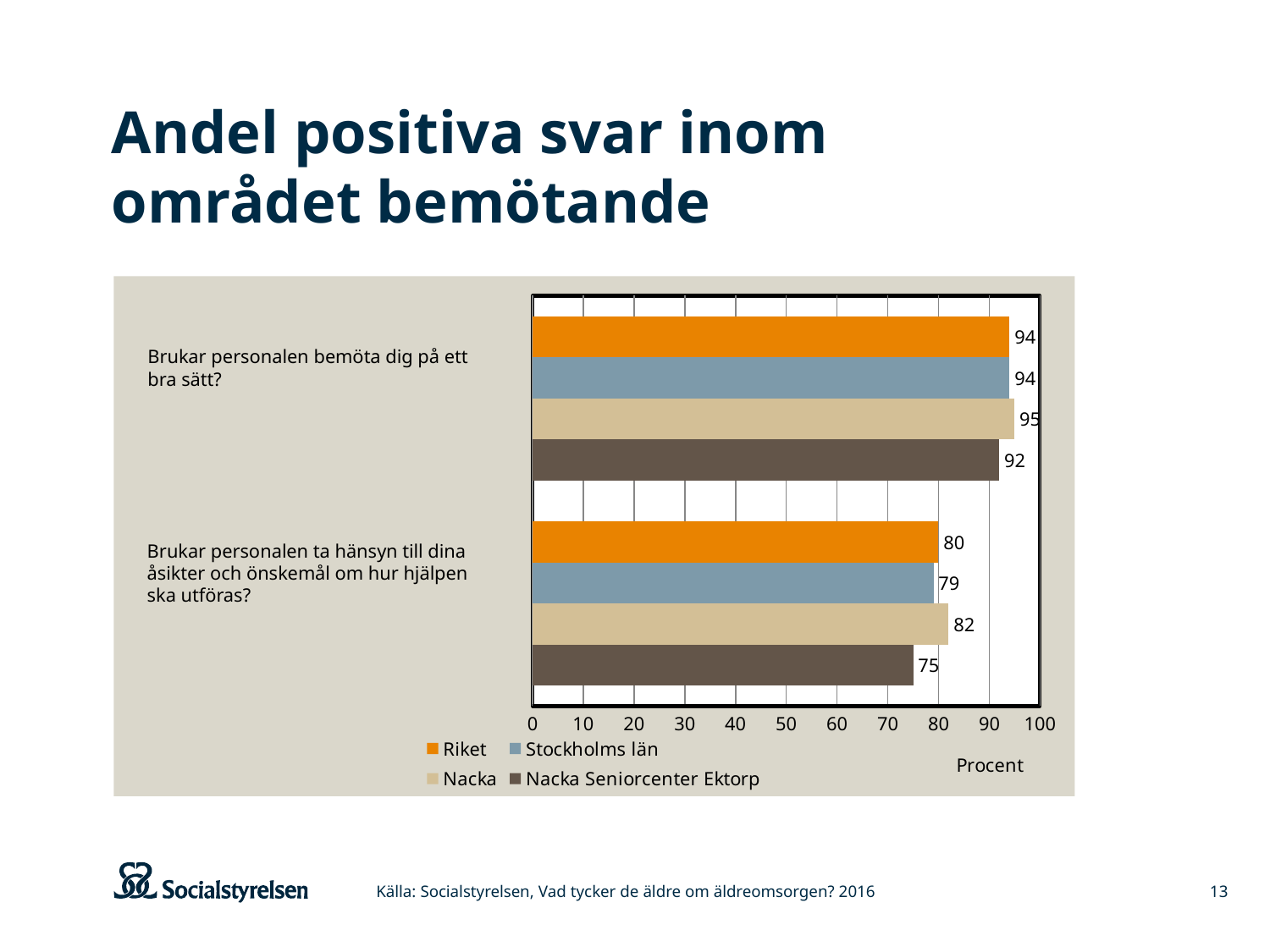
For "Brukar personalen ta hänsyn till dina åsikter och önskemål om hur hjälpen ska utföras?", which is larger: the value for Riket or the value for Nacka Seniorcenter Ektorp? Riket What kind of chart is shown on the slide? bar chart Which series has the lowest value for "Brukar personalen ta hänsyn till dina åsikter och önskemål om hur hjälpen ska utföras?"? Nacka Seniorcenter Ektorp What is the value for Stockholms län for "Brukar personalen bemöta dig på ett bra sätt?"? 94 What is the label on the horizontal axis of the chart? Procent What is the value for Nacka for "Brukar personalen ta hänsyn till dina åsikter och önskemål om hur hjälpen ska utföras?"? 82 What is the value for Riket for "Brukar personalen ta hänsyn till dina åsikter och önskemål om hur hjälpen ska utföras?"? 80 Which series has the highest value for "Brukar personalen bemöta dig på ett bra sätt?"? Nacka What is the value for Nacka Seniorcenter Ektorp for "Brukar personalen bemöta dig på ett bra sätt?"? 92 What is the difference between the Nacka value and the Nacka Seniorcenter Ektorp value for "Brukar personalen ta hänsyn till dina åsikter och önskemål om hur hjälpen ska utföras?"? 7 How many series does the legend list? 4 How many question categories are plotted on the chart? 2